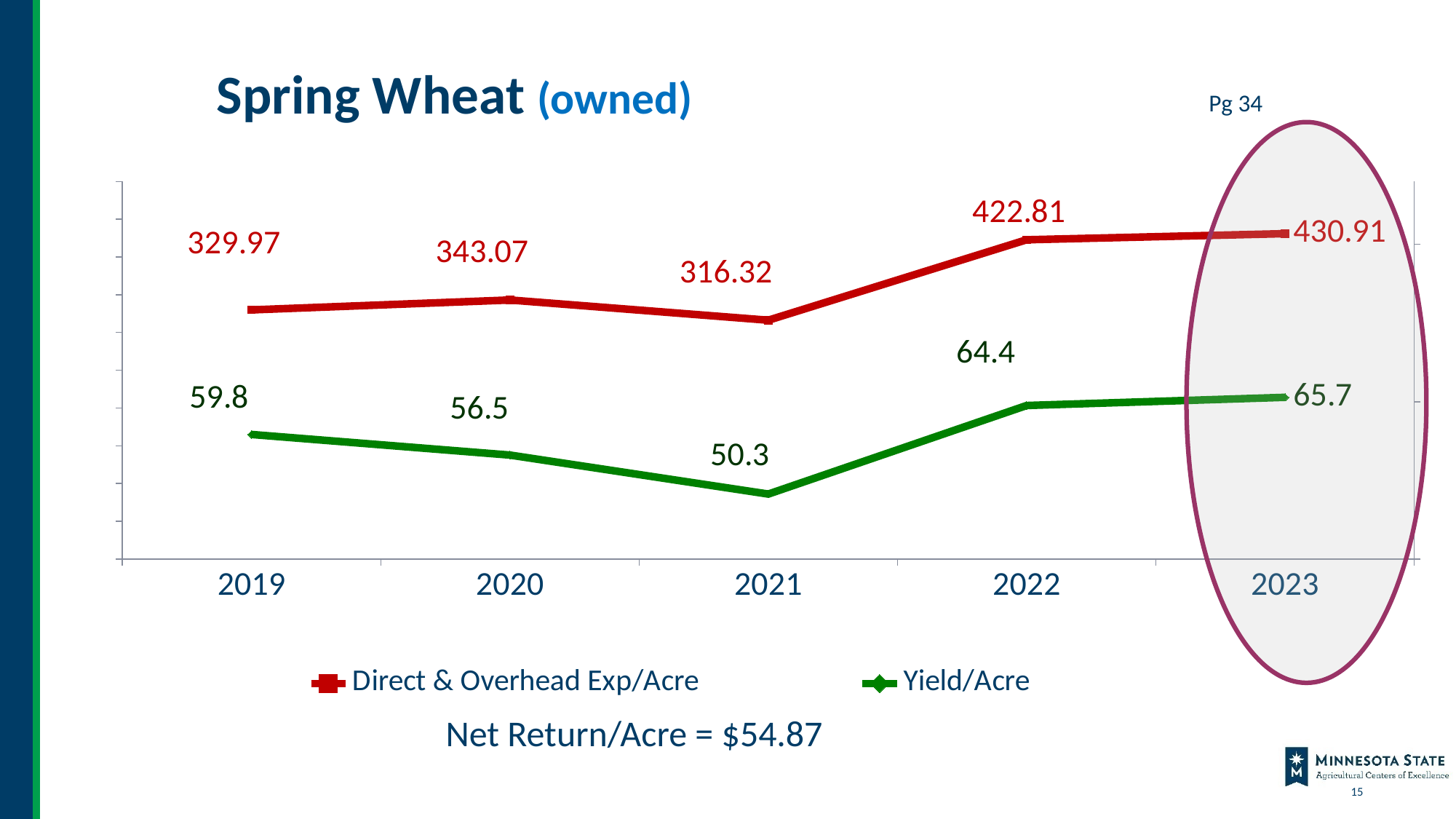
Which is larger, the Yield/Acre in 2019 or in 2020? 2019 What is the Direct & Overhead Exp/Acre value for 2023? 430.91 What kind of chart is shown on the slide? Line chart What is the difference in Yield/Acre between 2022 and 2021? 14.1 Which year has the highest Yield/Acre? 2023 What Net Return/Acre is stated below the chart? $54.87 How many years are shown on the x axis? 5 What is the Yield/Acre value for 2021? 50.3 How many series does the legend list? 2 What is the difference in Direct & Overhead Exp/Acre between 2023 and 2022? 8.10 Which year has the lowest Direct & Overhead Exp/Acre? 2021 What is the Direct & Overhead Exp/Acre value for 2019? 329.97